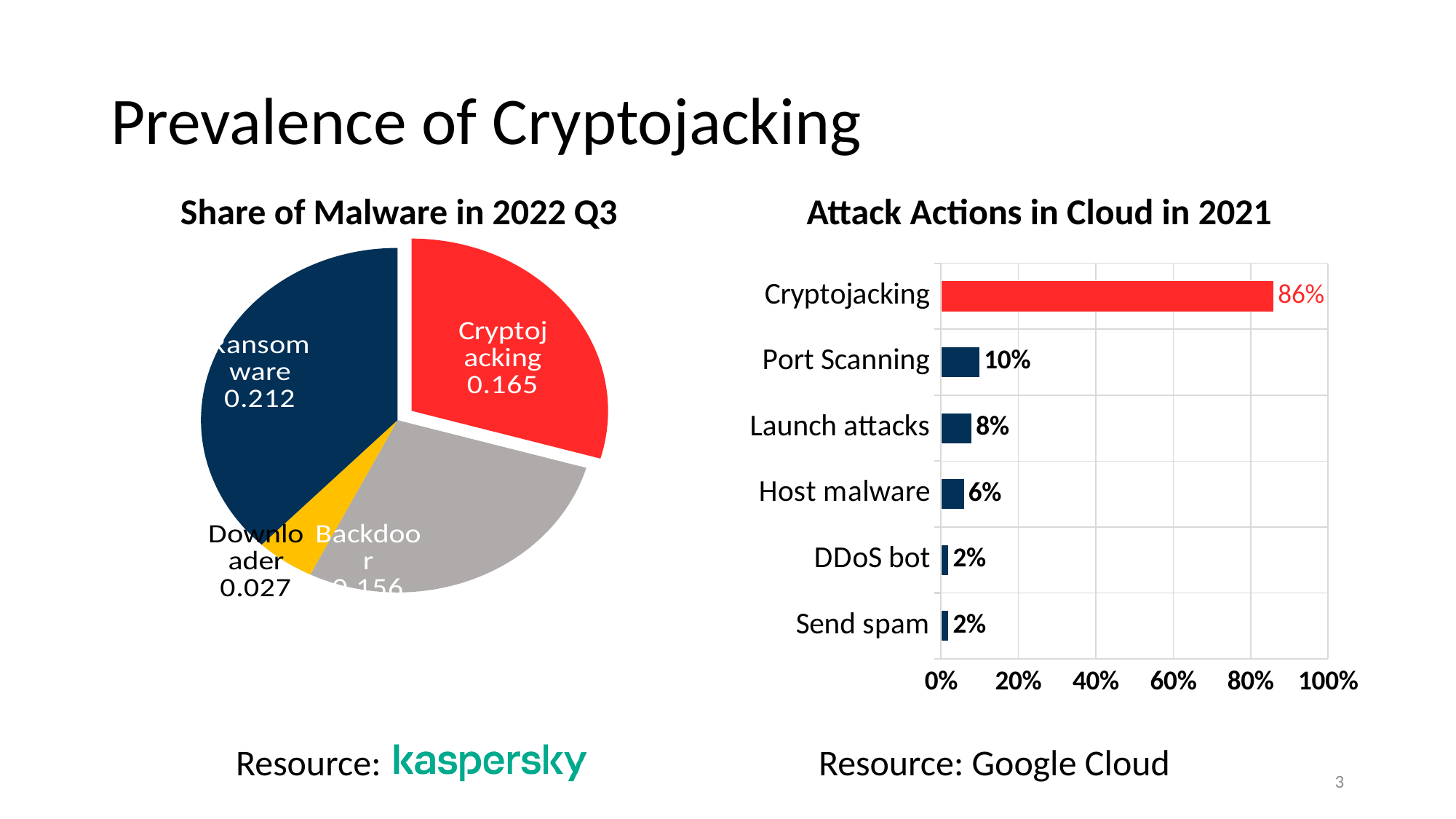
In the 'Attack Actions in Cloud in 2021' chart, which category has the highest value? Cryptojacking In the 'Share of Malware in 2022 Q3' chart, what is the value for Downloader? 0.027 In the 'Attack Actions in Cloud in 2021' chart, what is the value for Port Scanning? 10% In the 'Attack Actions in Cloud in 2021' chart, what is the difference between Cryptojacking and Port Scanning? 76% What kind of chart is 'Share of Malware in 2022 Q3'? Pie chart In the 'Share of Malware in 2022 Q3' chart, what is the value for Cryptojacking? 0.165 In the 'Attack Actions in Cloud in 2021' chart, what is the value for Host malware? 6% In the 'Share of Malware in 2022 Q3' chart, which is larger, Ransomware or Cryptojacking? Ransomware In the 'Attack Actions in Cloud in 2021' chart, how many categories are shown? 6 In the 'Attack Actions in Cloud in 2021' chart, which is larger, Launch attacks or Host malware? Launch attacks What kind of chart is 'Attack Actions in Cloud in 2021'? Bar chart In the 'Attack Actions in Cloud in 2021' chart, what is the value for Cryptojacking? 86%